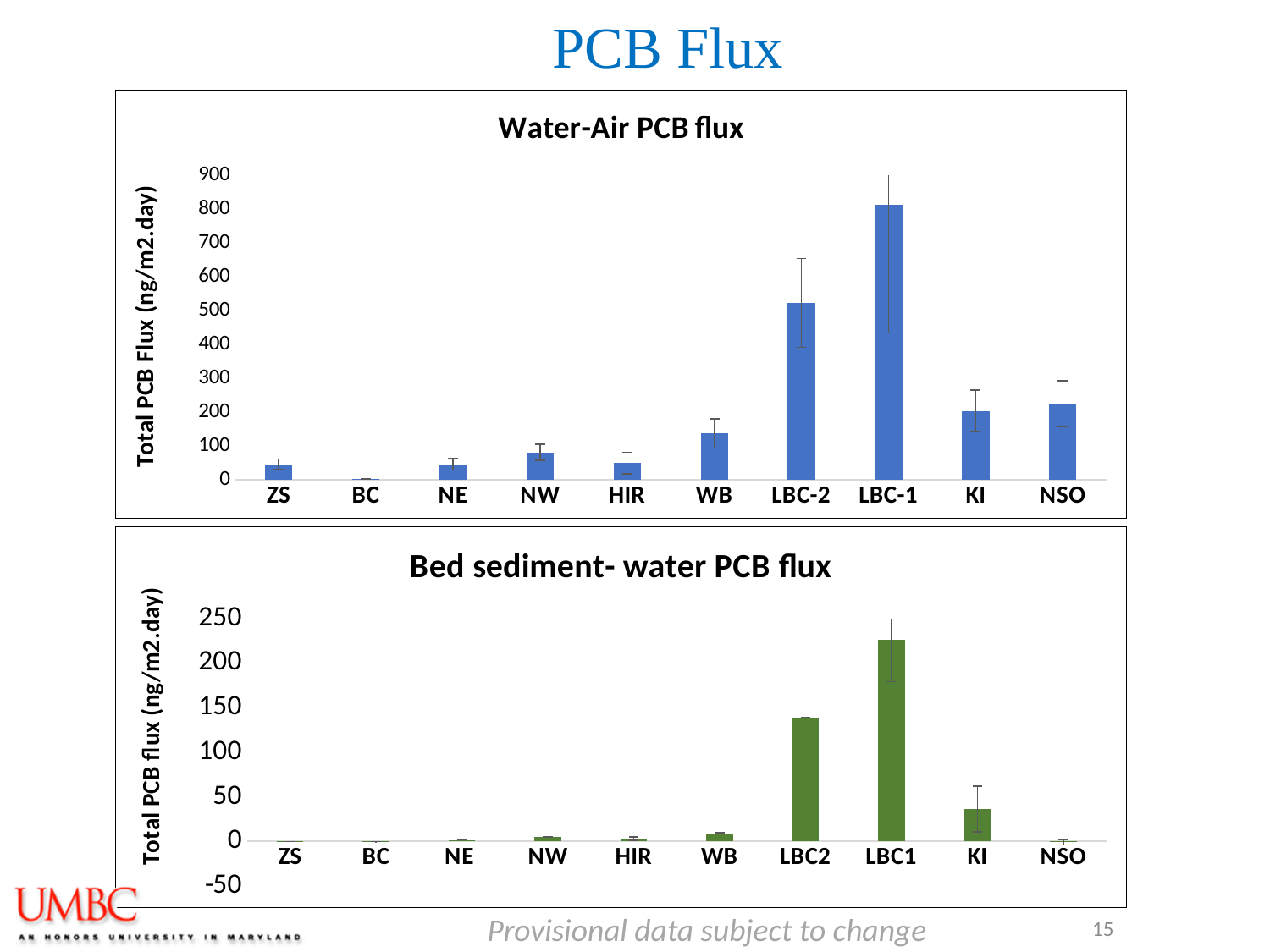
In the Water-Air PCB flux chart, is the value for WB greater or less than 100? greater In the Water-Air PCB flux chart, is the value for LBC-2 greater or less than 400? greater What is the y-axis label of the Water-Air PCB flux chart? Total PCB Flux (ng/m2.day) In the Water-Air PCB flux chart, is the value for LBC-1 greater or less than 700? greater How many sites are shown on the x axis of the Water-Air PCB flux chart? 10 In the Water-Air PCB flux chart, which site has the highest total PCB flux? LBC-1 In the Bed sediment- water PCB flux chart, which site has the highest total PCB flux? LBC1 In the Water-Air PCB flux chart, which site has the lowest total PCB flux? BC In the Water-Air PCB flux chart, which is larger, the value for LBC-1 or the value for LBC-2? LBC-1 What kind of chart is the Bed sediment- water PCB flux chart? bar chart